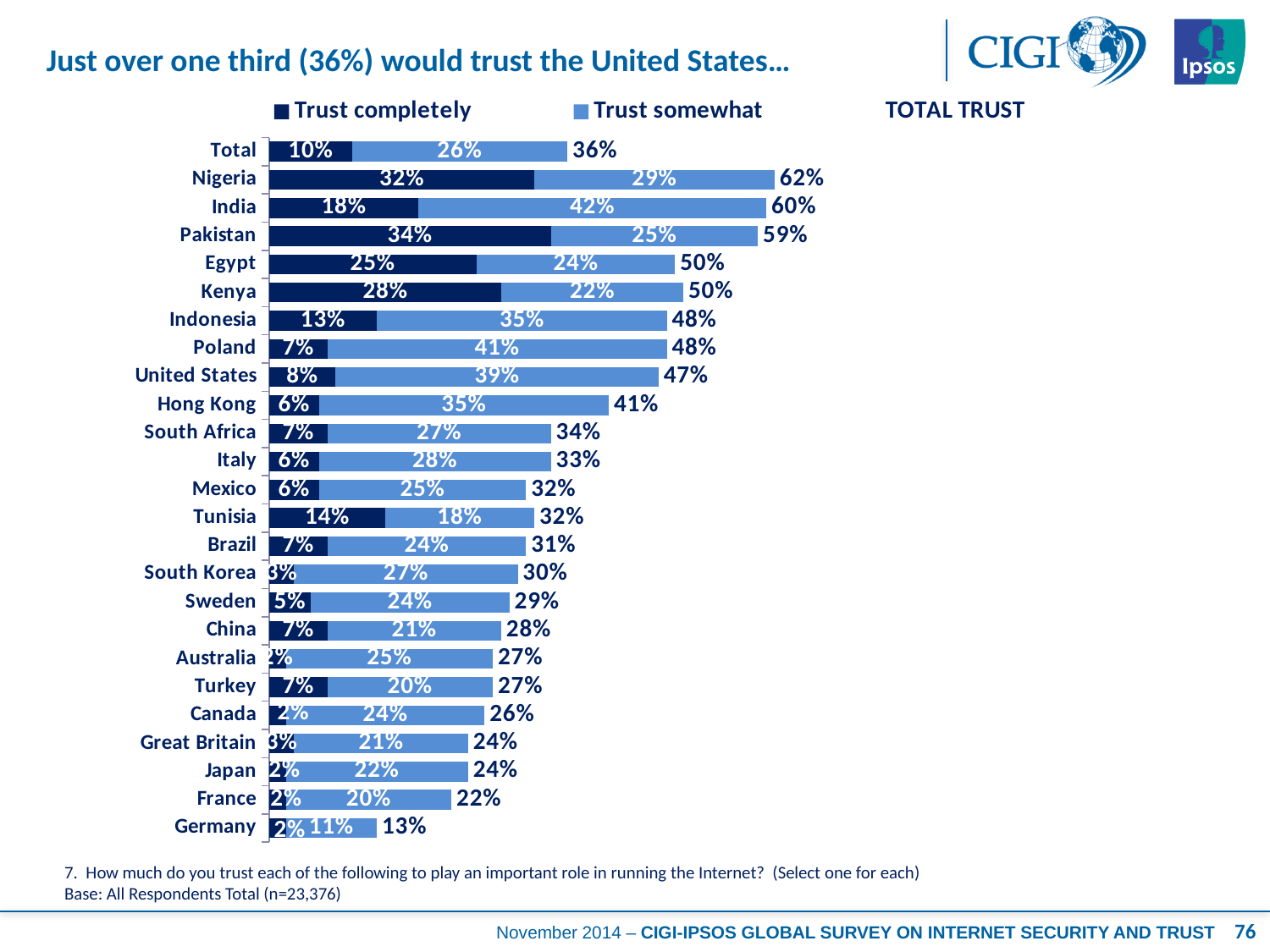
What are the two series named in the legend? Trust completely and Trust somewhat What is the total trust value for the United States? 47% How many series does the legend list? 2 What is the 'Trust somewhat' value for Poland? 41% Which country has the highest total trust? Nigeria What is the 'Trust completely' value for Pakistan? 34% What kind of chart is shown on the slide? Stacked bar chart Which country has the lowest total trust? Germany What is the 'Trust somewhat' value for India? 42% What is the difference between the total trust for Nigeria and the total trust for Germany? 49% What is the total of the stacked bar for Hong Kong? 41% Which is larger, the 'Trust completely' value for Kenya or the 'Trust completely' value for Egypt? Kenya